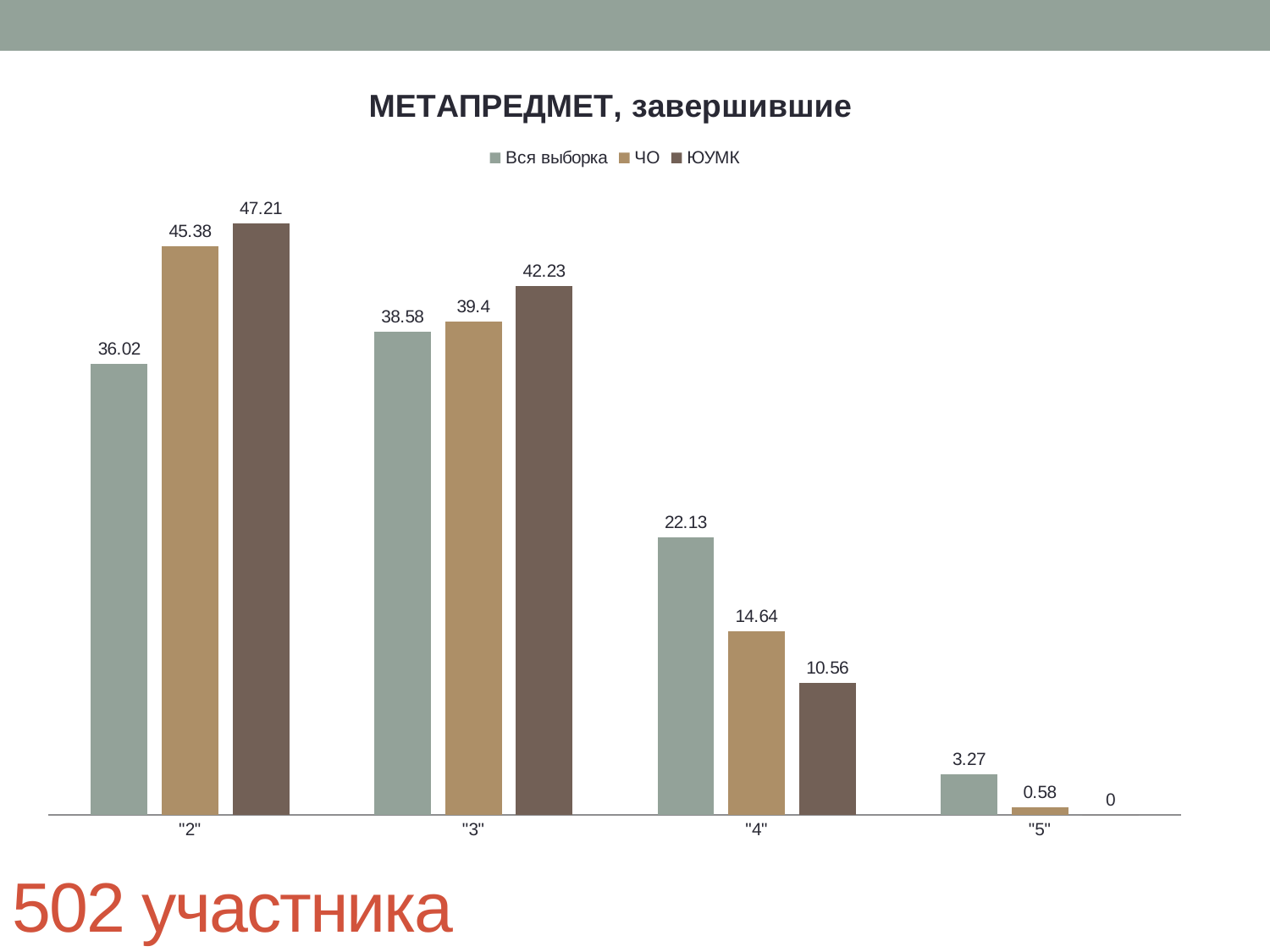
What is the value for ЧО in category "5"? 0.58 In which category does the ЮУМК series reach its highest value? "2" What is the value for ЮУМК in category "2"? 47.21 What is the difference between the ЮУМК and Вся выборка values in category "2"? 11.19 What is the value for ЧО in category "3"? 39.4 How many series does the legend list? 3 In which category does the Вся выборка series have its lowest value? "5" Which is larger in category "4": the value for ЧО or the value for ЮУМК? ЧО What is the title of the chart? МЕТАПРЕДМЕТ, завершившие How many categories are shown on the x axis? 4 What is the value for Вся выборка in category "4"? 22.13 What kind of chart is shown on the slide? bar chart